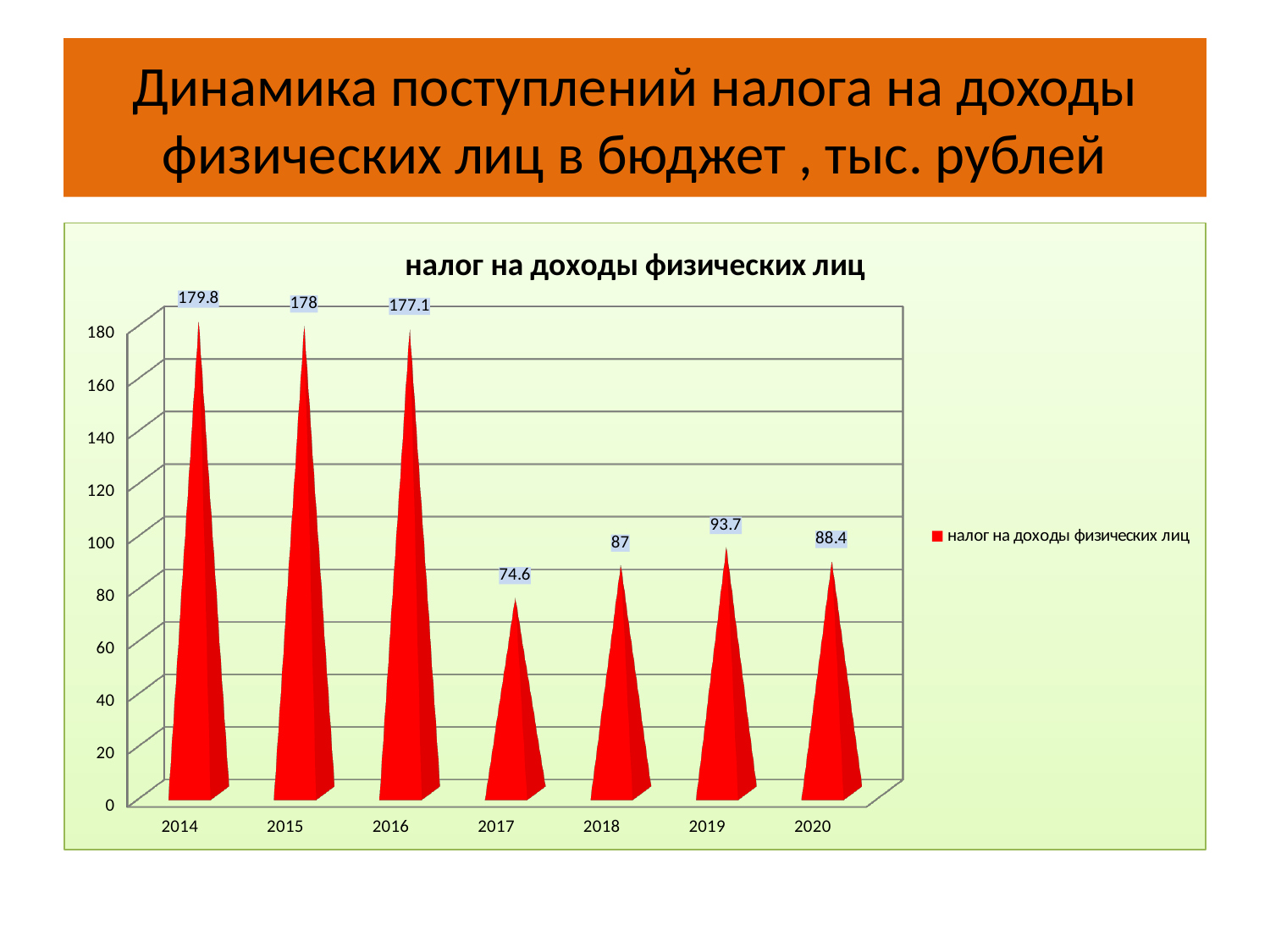
Is the value for 2016 greater or less than 160? greater Which year has the highest value? 2014 Which year has the lowest value? 2017 What is the value for 2014? 179.8 How many years are shown on the x axis? 7 What is the difference between the values for 2019 and 2018? 6.7 What is the title of the chart? налог на доходы физических лиц Which is larger, the value for 2019 or the value for 2020? 2019 What is the difference between the values for 2014 and 2017? 105.2 What kind of chart is shown? bar chart What is the value for 2020? 88.4 What is the value for 2017? 74.6